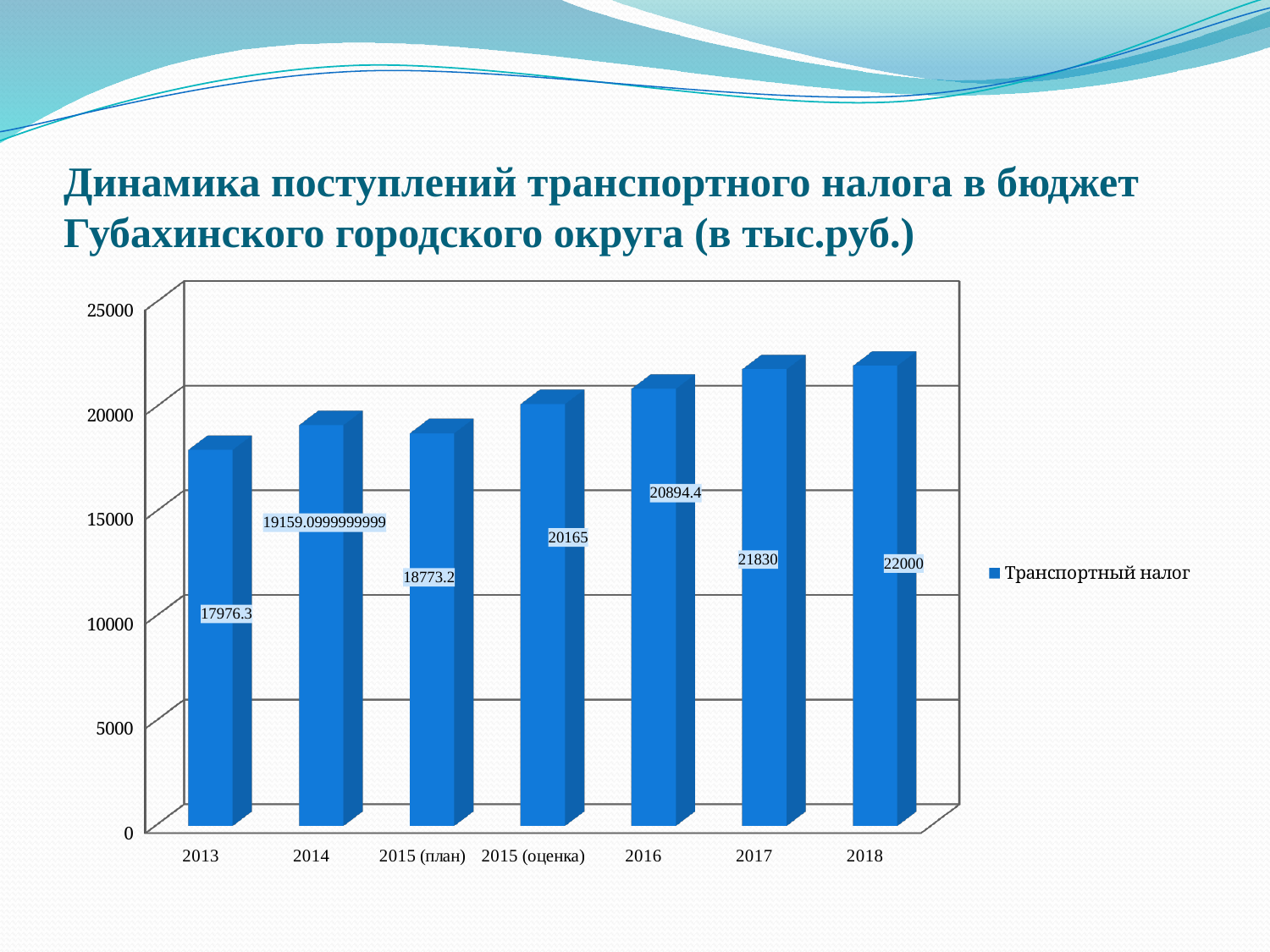
Which category has the lowest value? 2013 Which is larger, the value for 2015 (план) or the value for 2015 (оценка)? 2015 (оценка) What kind of chart is shown on the slide? bar chart How many categories are shown on the x axis? 7 What is the value for 2013? 17976.3 What is the difference between the values for 2018 and 2017? 170 Which category has the highest value? 2018 Is the value for 2017 greater or less than 20000? greater What is the value for 2016? 20894.4 What is the value for 2015 (план)? 18773.2 What series name does the legend show? Транспортный налог What is the value for 2018? 22000